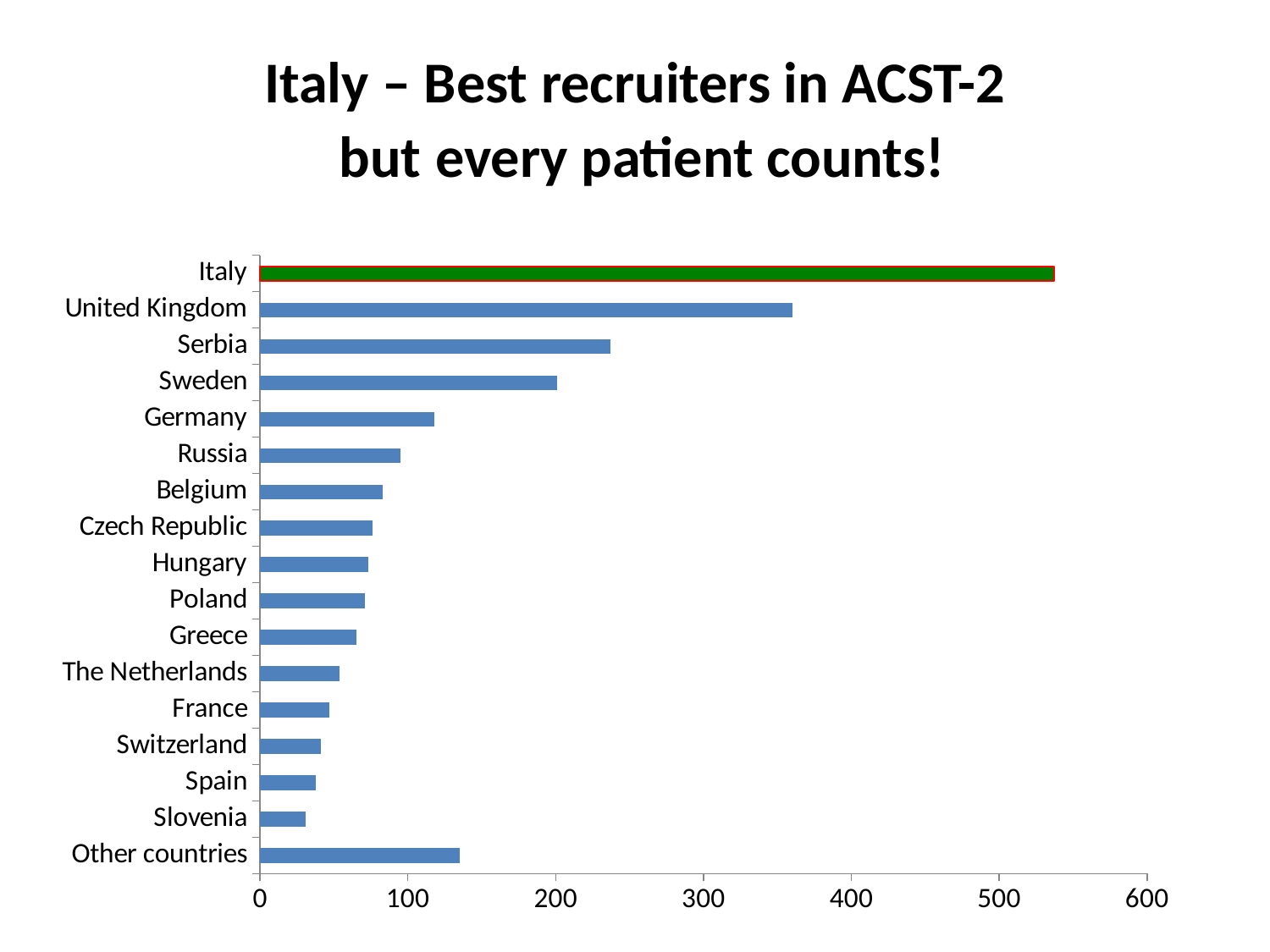
Is the value for Other countries greater or less than 100? greater Which category has the highest value? Italy What kind of chart is shown on the slide? bar chart Is the value for Italy greater or less than 500? greater What colour is the bar for Italy? green Which is larger, the value for Other countries or the value for Germany? Other countries Is the value for Germany greater or less than 100? greater Which is larger, the value for United Kingdom or the value for Serbia? United Kingdom Which category has the lowest value? Slovenia How many categories are plotted on the chart? 17